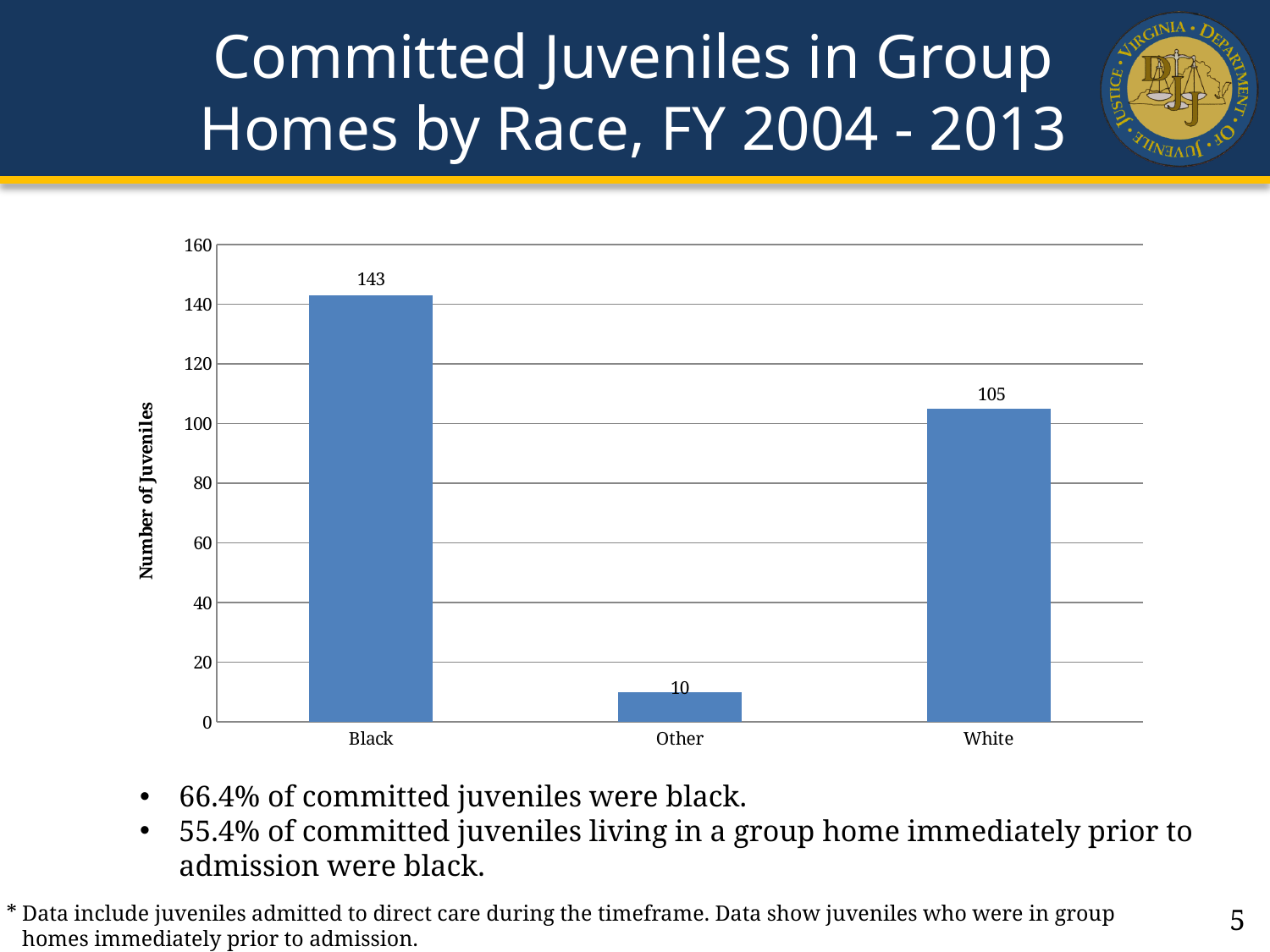
Which is larger, the value for Black or the value for White? Black What is the difference between the number of juveniles for Black and White? 38 How many race categories are shown on the x axis? 3 What is the label of the y axis? Number of Juveniles Is the value for White greater or less than 100? greater What kind of chart is shown on the slide? bar chart What is the number of juveniles for the Black category? 143 Which race category has the highest number of juveniles? Black Which race category has the lowest number of juveniles? Other What is the number of juveniles for the White category? 105 What is the difference between the number of juveniles for White and Other? 95 What is the number of juveniles for the Other category? 10